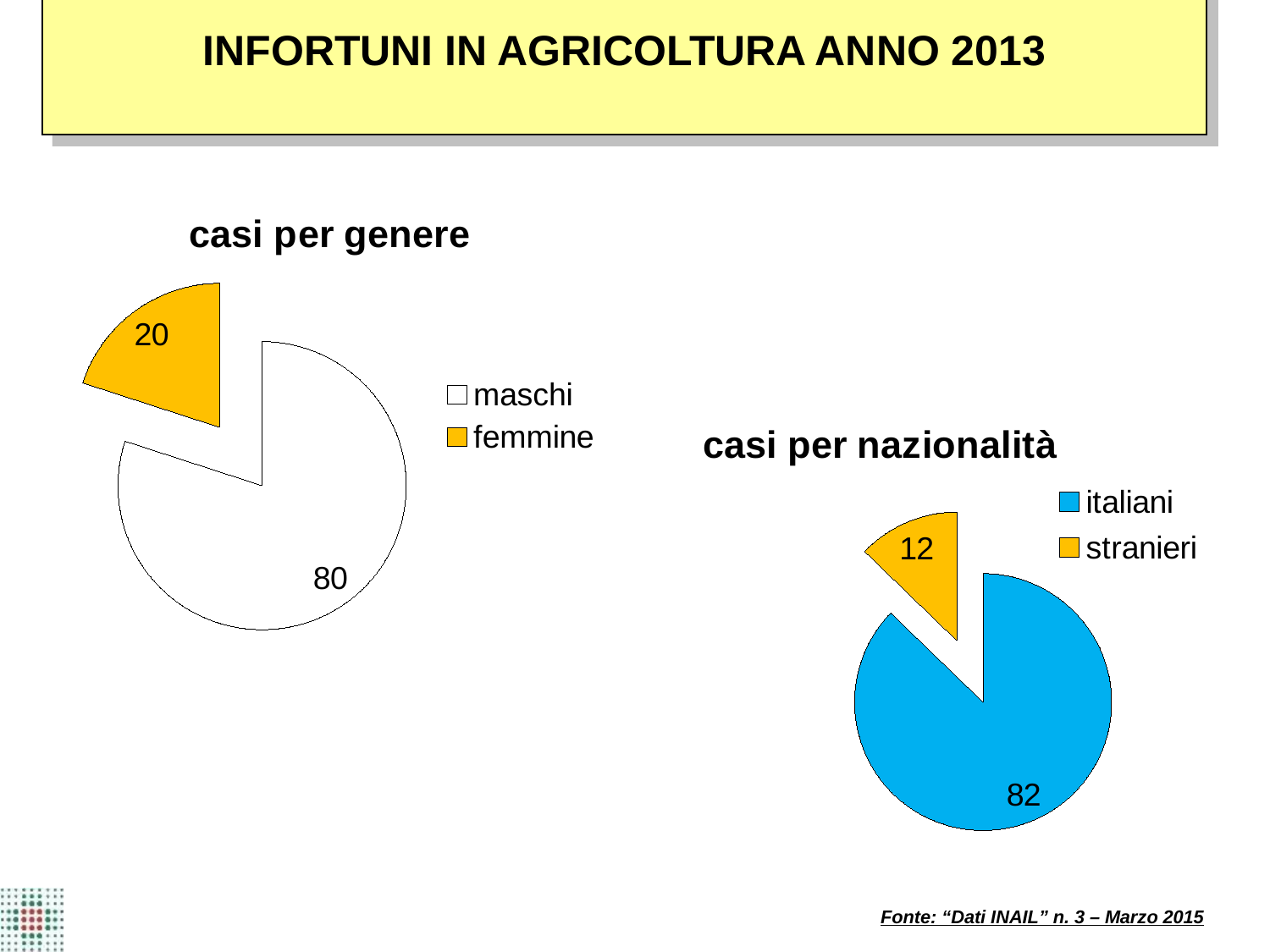
In the 'casi per genere' chart, which category has the largest slice? maschi In the 'casi per nazionalità' chart, what is the value for italiani? 82 In the 'casi per genere' chart, what is the value for femmine? 20 What type of chart is 'casi per genere'? pie chart In the 'casi per nazionalità' chart, which category has the smallest slice? stranieri In the 'casi per genere' chart, what share of the pie does the maschi slice represent? 80% In the 'casi per genere' chart, what is the value for maschi? 80 In the 'casi per genere' chart, what is the difference between the values for maschi and femmine? 60 How many categories does the legend of the 'casi per nazionalità' chart list? 2 In the 'casi per nazionalità' chart, what is the difference between the values for italiani and stranieri? 70 In the 'casi per nazionalità' chart, which is larger, italiani or stranieri? italiani In the 'casi per nazionalità' chart, what is the value for stranieri? 12